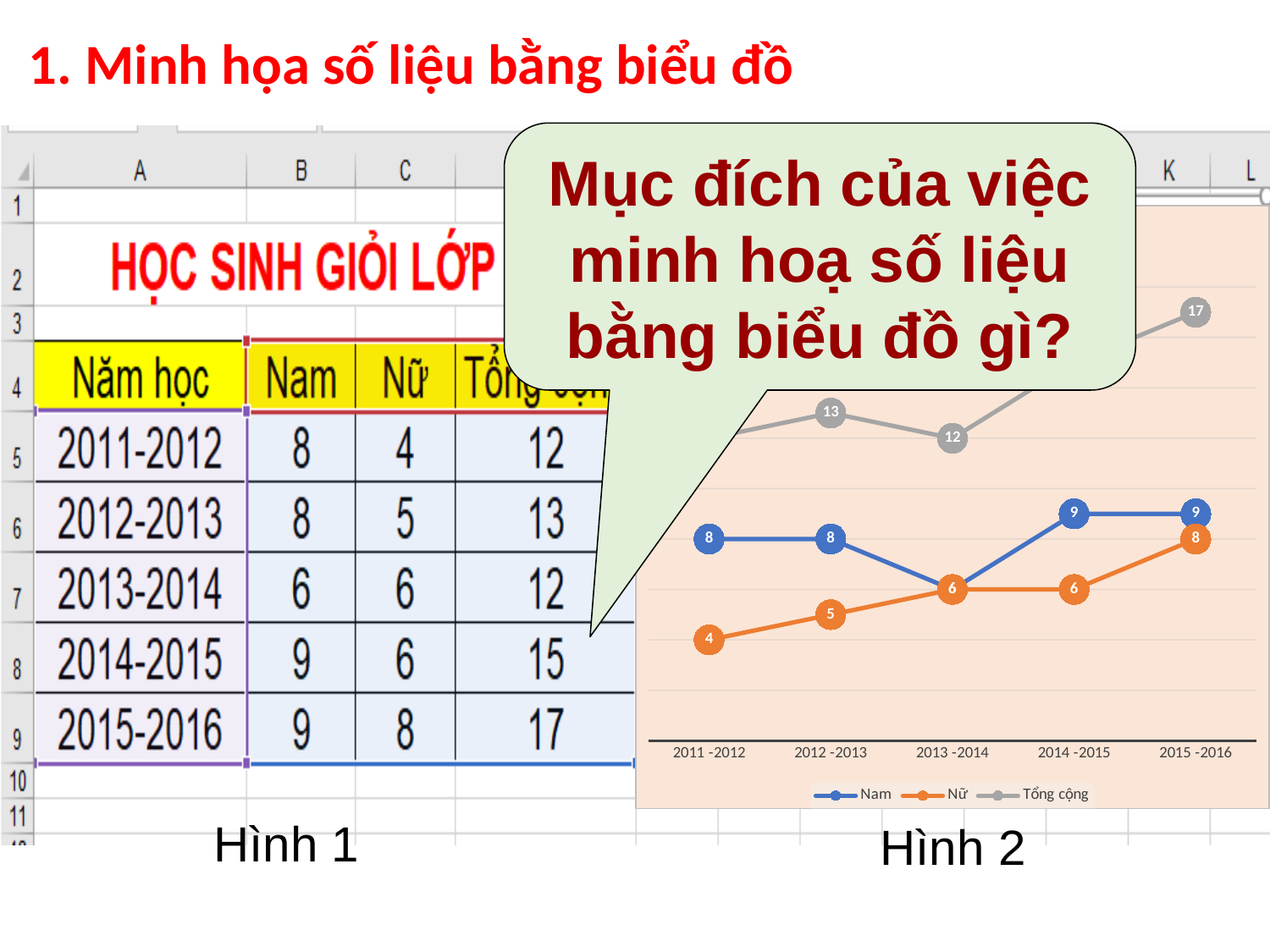
What kind of chart is Hình 2? line chart In the chart in Hình 2, what is the value of Nữ for 2015-2016? 8 How many school years are shown on the x axis of the chart in Hình 2? 5 In the chart in Hình 2, which school year has the lowest value for Nữ? 2011-2012 In the chart in Hình 2, does the Nữ series rise or fall from 2011-2012 to 2015-2016? rise In the chart in Hình 2, what is the value of Nữ for 2011-2012? 4 In the chart in Hình 2, what is the difference between Nam and Nữ for 2012-2013? 3 In the chart in Hình 2, which school year has the highest value for Tổng cộng? 2015-2016 In the chart in Hình 2, what is the value of Tổng cộng for 2015-2016? 17 In the chart in Hình 2, which is larger for 2014-2015, Nam or Nữ? Nam How many series does the legend of the chart in Hình 2 list? 3 In the chart in Hình 2, what is the value of Nam for 2013-2014? 6